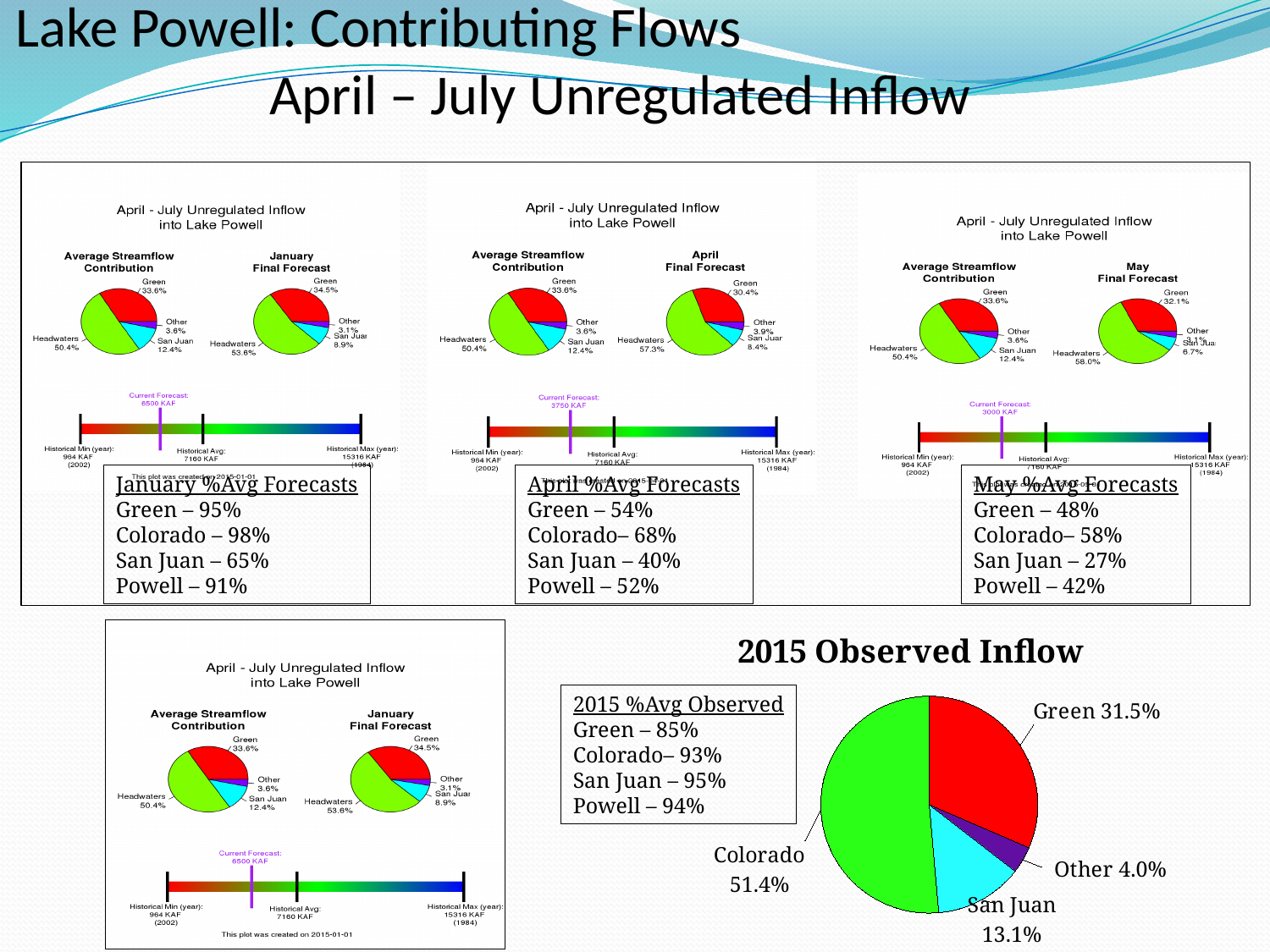
In the May Final Forecast pie (top-right panel), what percentage is Green? 32.1% How many slices does the 2015 Observed Inflow pie chart have? 4 In the 2015 Observed Inflow pie chart, what is the difference between the Green share and the Other share? 27.5 percentage points Which is larger: the Headwaters share in the April Final Forecast pie or in the May Final Forecast pie? May Final Forecast In the January Final Forecast pie (top-left panel), what percentage is Headwaters? 53.6% In the Average Streamflow Contribution pie (top-left panel), what percentage is San Juan? 12.4% In the 2015 Observed Inflow pie chart, which slice is the smallest? Other In the April Final Forecast pie (top-middle panel), what percentage is Headwaters? 57.3% In the 2015 Observed Inflow pie chart, what share does Colorado have? 51.4% In the top-middle panel (April), what is the Current Forecast value shown on the gradient bar? 3750 KAF What kind of chart is the 2015 Observed Inflow chart? Pie chart In the 2015 Observed Inflow pie chart, which slice is the largest? Colorado